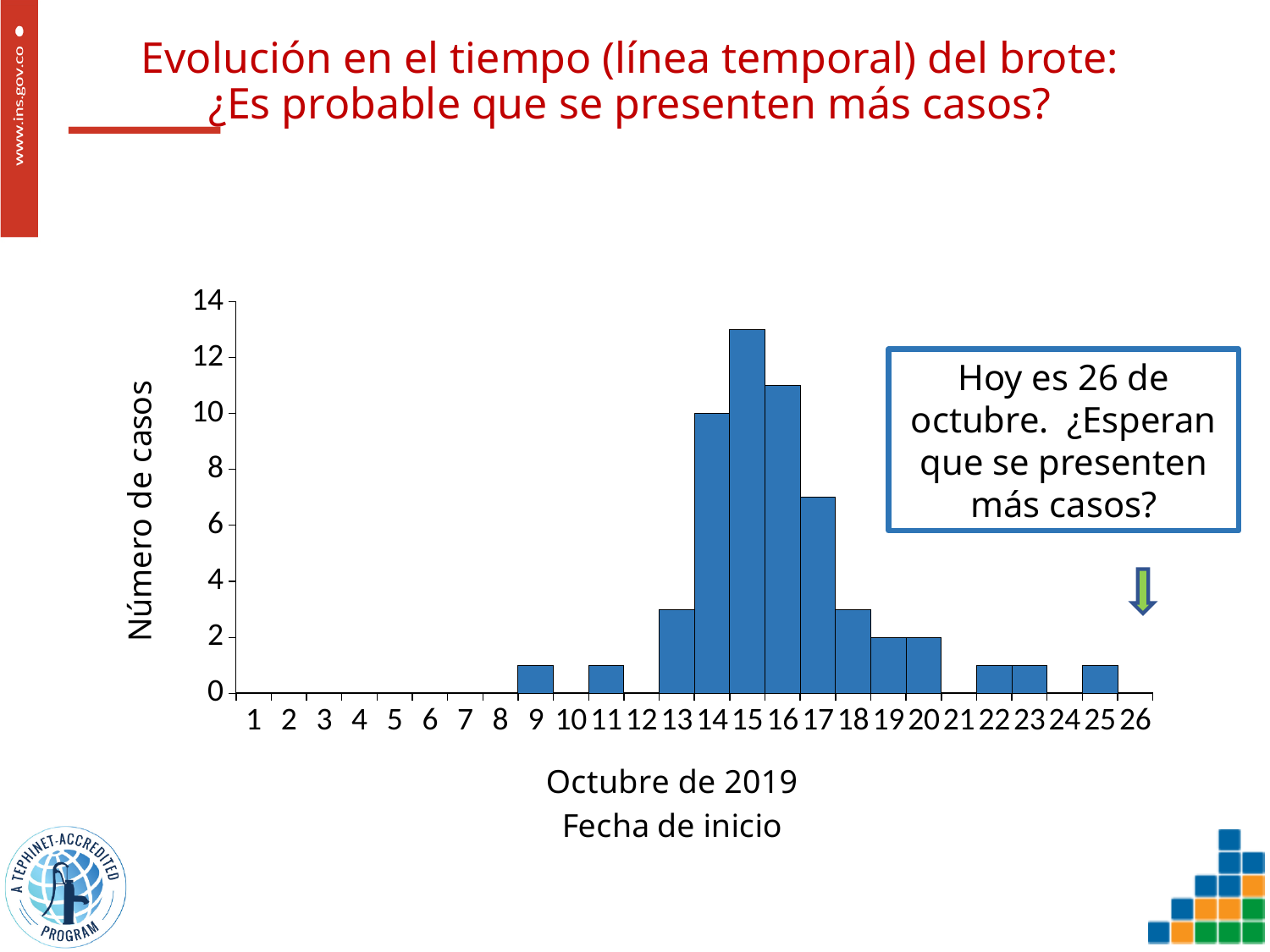
Is the number of cases for October 13 greater or less than 2? greater Do the number of cases rise or fall from October 15 to October 20? fall Is the number of cases for October 15 greater or less than 12? greater What is the difference in the number of cases between October 14 and October 19? 8 How many cases are shown for October 20? 2 On which day of October 2019 is the number of cases highest? 15 What is the label of the y-axis? Número de casos What type of chart is shown on the slide? bar chart Is the number of cases for October 17 greater or less than 8? less How many cases are shown for October 19? 2 How many cases are shown for October 14? 10 Which day has more cases, October 15 or October 17? October 15